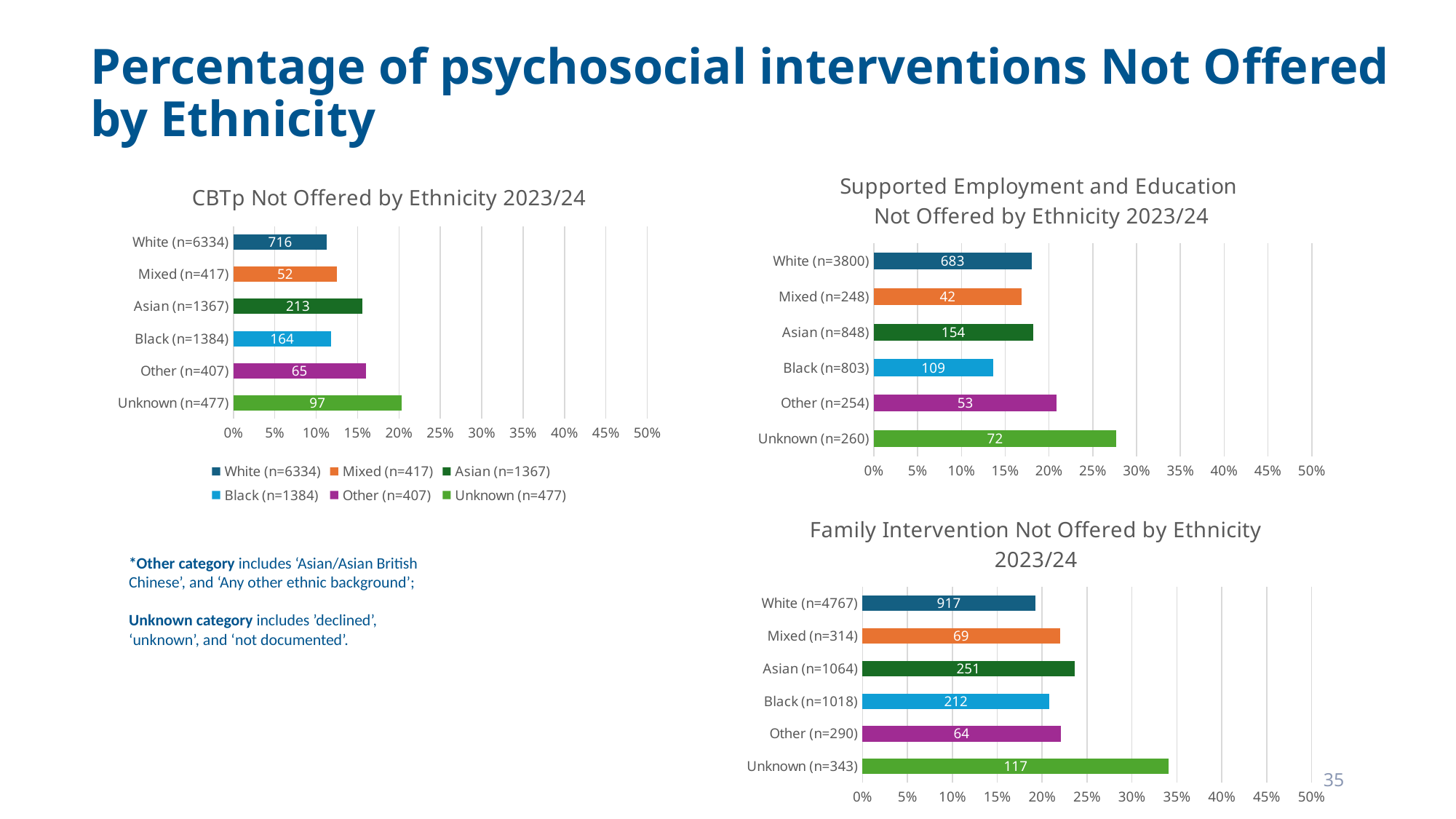
In the Supported Employment and Education Not Offered by Ethnicity 2023/24 chart, is the percentage for Unknown (n=260) greater or less than 25%? greater In the CBTp Not Offered by Ethnicity 2023/24 chart, is the bar for Unknown (n=477) longer or shorter than the bar for Asian (n=1367)? longer In the CBTp Not Offered by Ethnicity 2023/24 chart, which ethnicity category has the longest bar? Unknown (n=477) In the Family Intervention Not Offered by Ethnicity 2023/24 chart, what is the difference between the numbers printed on the Asian (n=1064) and Black (n=1018) bars? 39 In the Family Intervention Not Offered by Ethnicity 2023/24 chart, which ethnicity category has the longest bar? Unknown (n=343) In the Family Intervention Not Offered by Ethnicity 2023/24 chart, what number is printed on the bar for Asian (n=1064)? 251 In the Supported Employment and Education Not Offered by Ethnicity 2023/24 chart, which ethnicity category has the shortest bar? Black (n=803) What kind of chart is the Family Intervention Not Offered by Ethnicity 2023/24 chart? bar chart In the Supported Employment and Education Not Offered by Ethnicity 2023/24 chart, what number is printed on the bar for Black (n=803)? 109 In the CBTp Not Offered by Ethnicity 2023/24 chart, what number is printed on the bar for White (n=6334)? 716 How many ethnicity categories are shown in the CBTp Not Offered by Ethnicity 2023/24 chart? 6 In the Family Intervention Not Offered by Ethnicity 2023/24 chart, is the percentage for Unknown (n=343) greater or less than 30%? greater